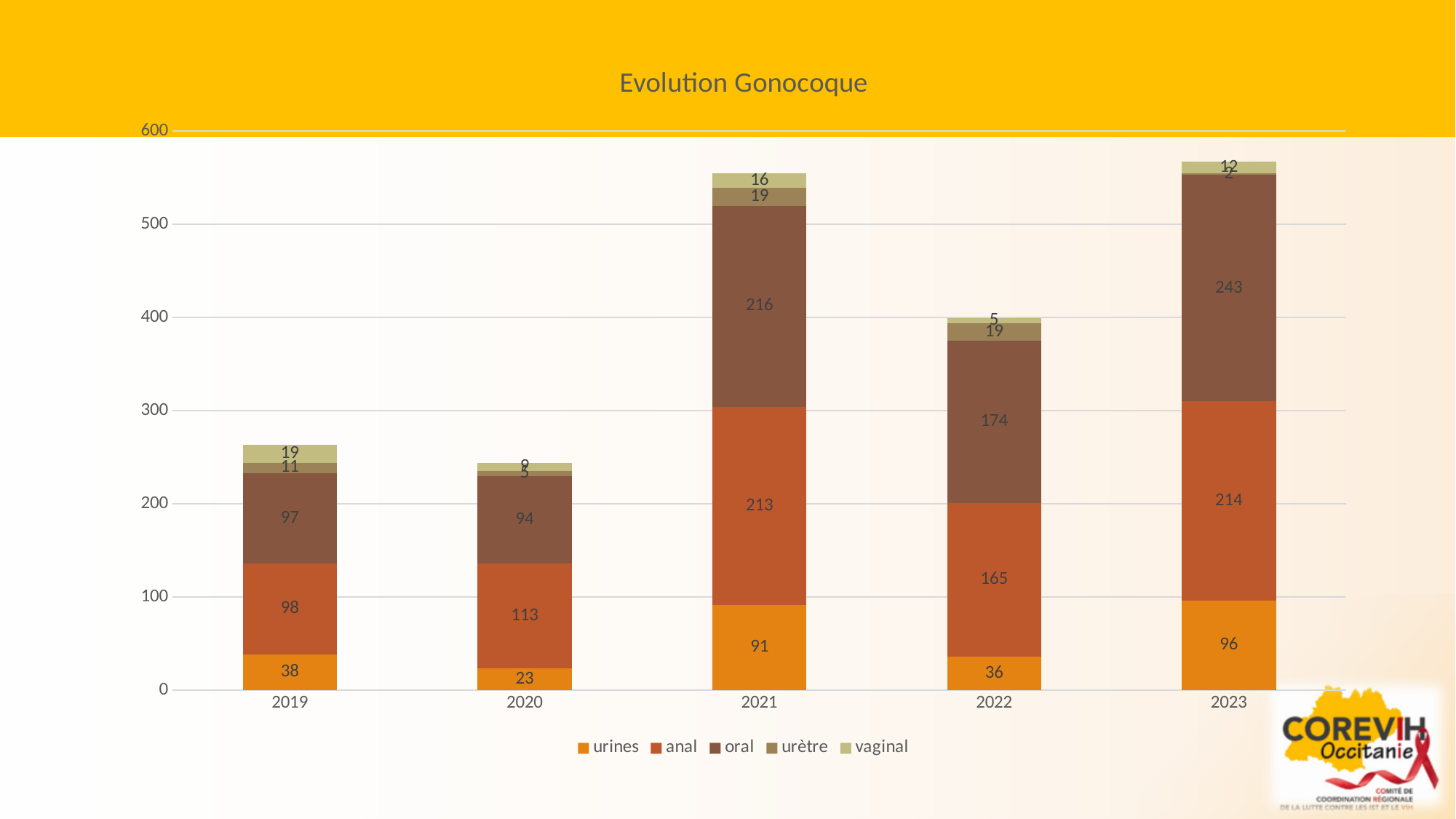
How many years are shown on the x axis? 5 Which year has the lowest value for urines? 2020 What is the value for oral in 2023? 243 What is the difference between the anal value in 2021 and the anal value in 2019? 115 What is the total of the stacked bar for 2019? 263 In 2022, which is larger: the oral value or the anal value? oral Which year has the highest value for oral? 2023 What kind of chart is shown on the slide? stacked bar chart How many series does the legend list? 5 What is the value for urines in 2021? 91 What is the value for anal in 2020? 113 Is the total of the stacked bar for 2021 greater or less than 500? greater